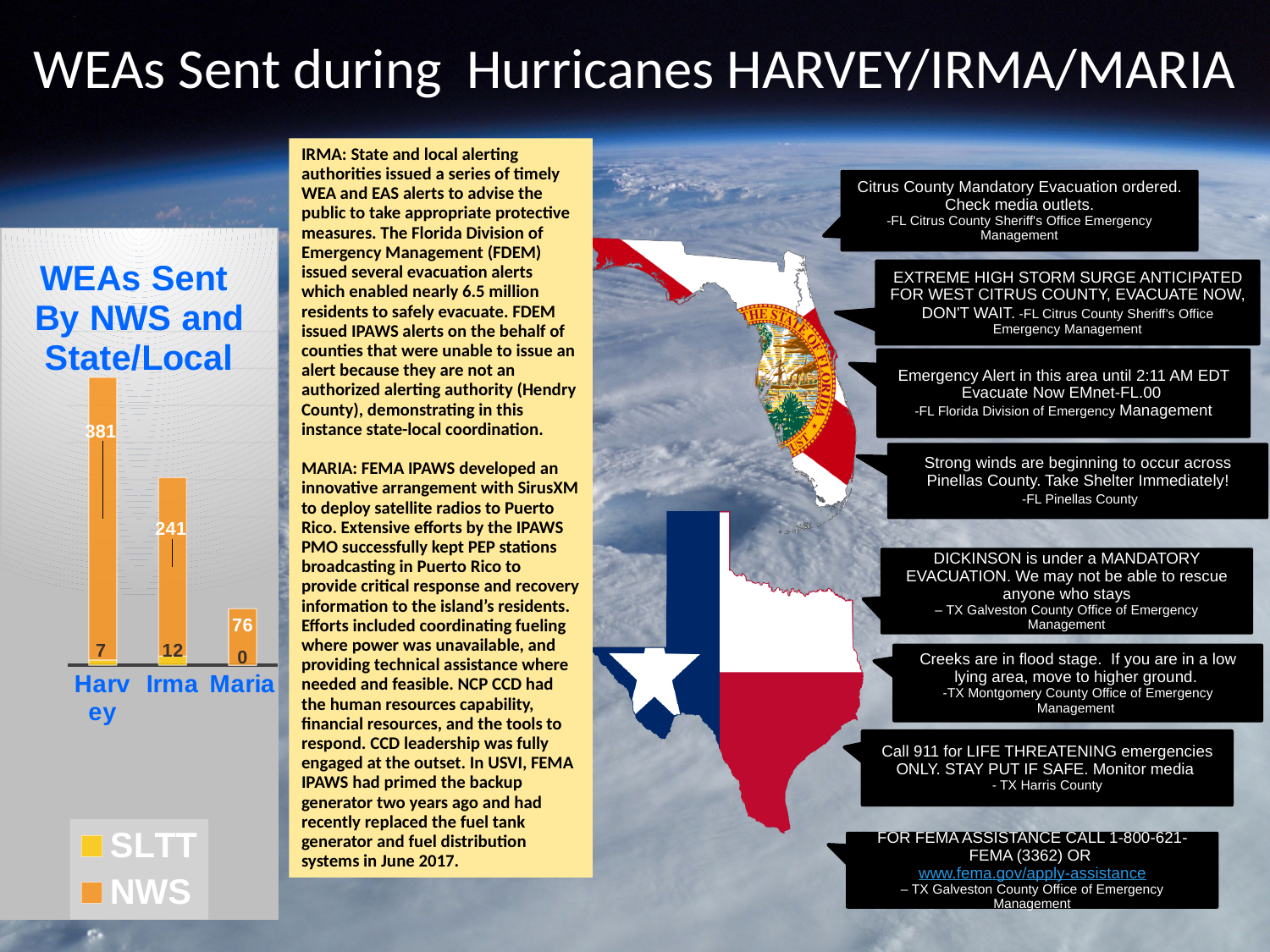
What is the total of the stacked bar for Irma in the chart? 253 What is the NWS value for Harvey in the chart? 381 What is the difference between the NWS values for Harvey and Irma in the chart? 140 Which hurricane has the highest NWS value in the chart? Harvey How many hurricane categories are shown on the chart's x axis? 3 Which hurricane has the lowest SLTT value in the chart? Maria What is the title of the chart on the slide? WEAs Sent By NWS and State/Local What is the SLTT value for Irma in the chart? 12 What is the NWS value for Maria in the chart? 76 What kind of chart is shown on the slide? stacked bar chart How many series does the chart legend list? 2 What is the SLTT value for Maria in the chart? 0